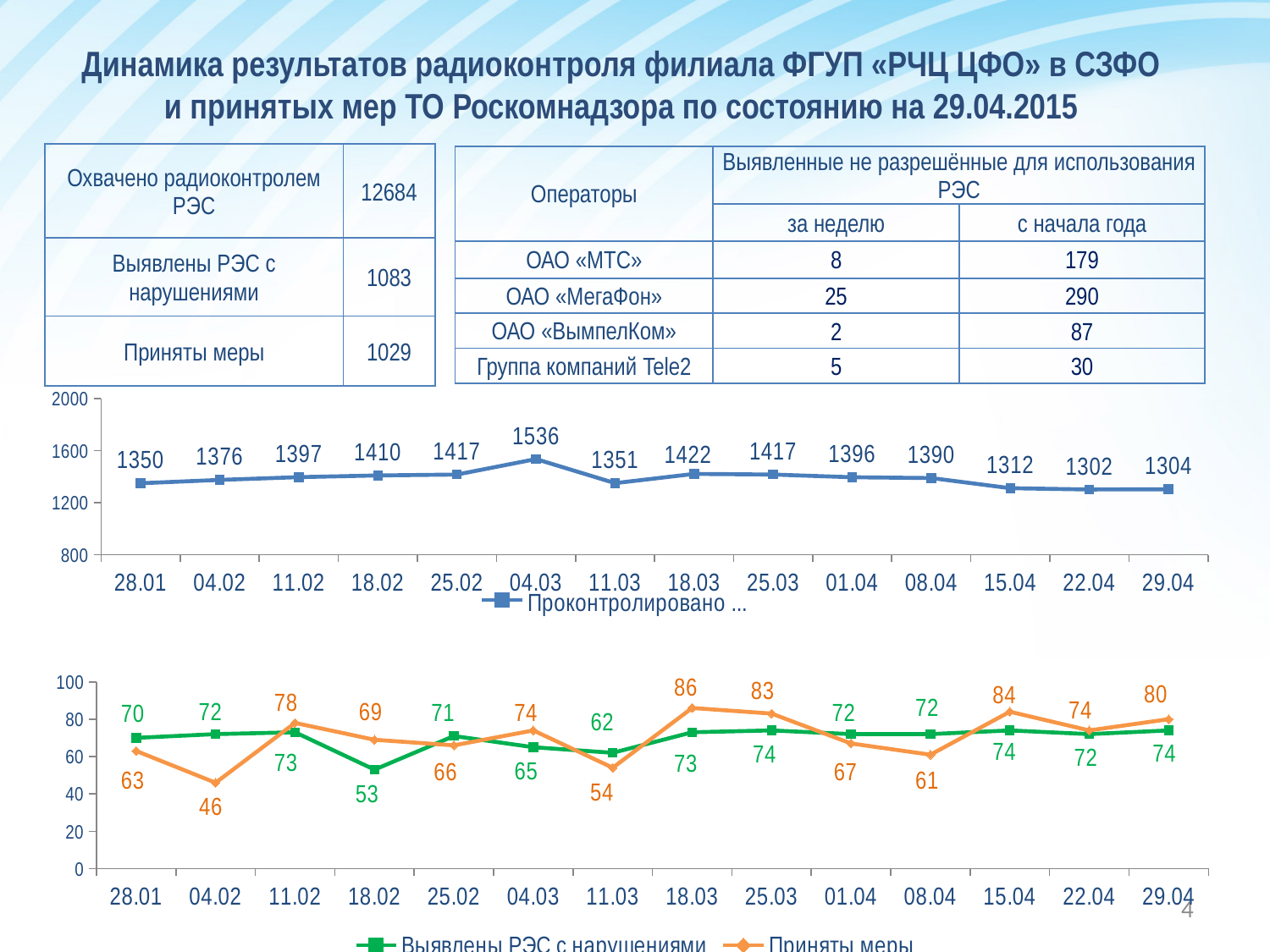
How many series does the legend of the bottom chart list? 2 In the bottom chart, what is the value of the Приняты меры series for 18.03? 86 In the bottom chart, which is larger on 11.03: Выявлены РЭС с нарушениями or Приняты меры? Выявлены РЭС с нарушениями In the top chart, what is the difference between the values for 04.03 and 11.03? 185 In the top chart, what is the value for 04.03? 1536 What kind of chart is the top chart? line chart How many data points are plotted in the top chart? 14 In the bottom chart, what is the difference between the Приняты меры and Выявлены РЭС с нарушениями values on 04.02? 26 In the bottom chart, which date has the lowest value for the Приняты меры series? 04.02 In the bottom chart, what is the value of the Выявлены РЭС с нарушениями series for 18.02? 53 In the top chart, which date has the highest value? 04.03 In the top chart, which date has the lowest value? 22.04